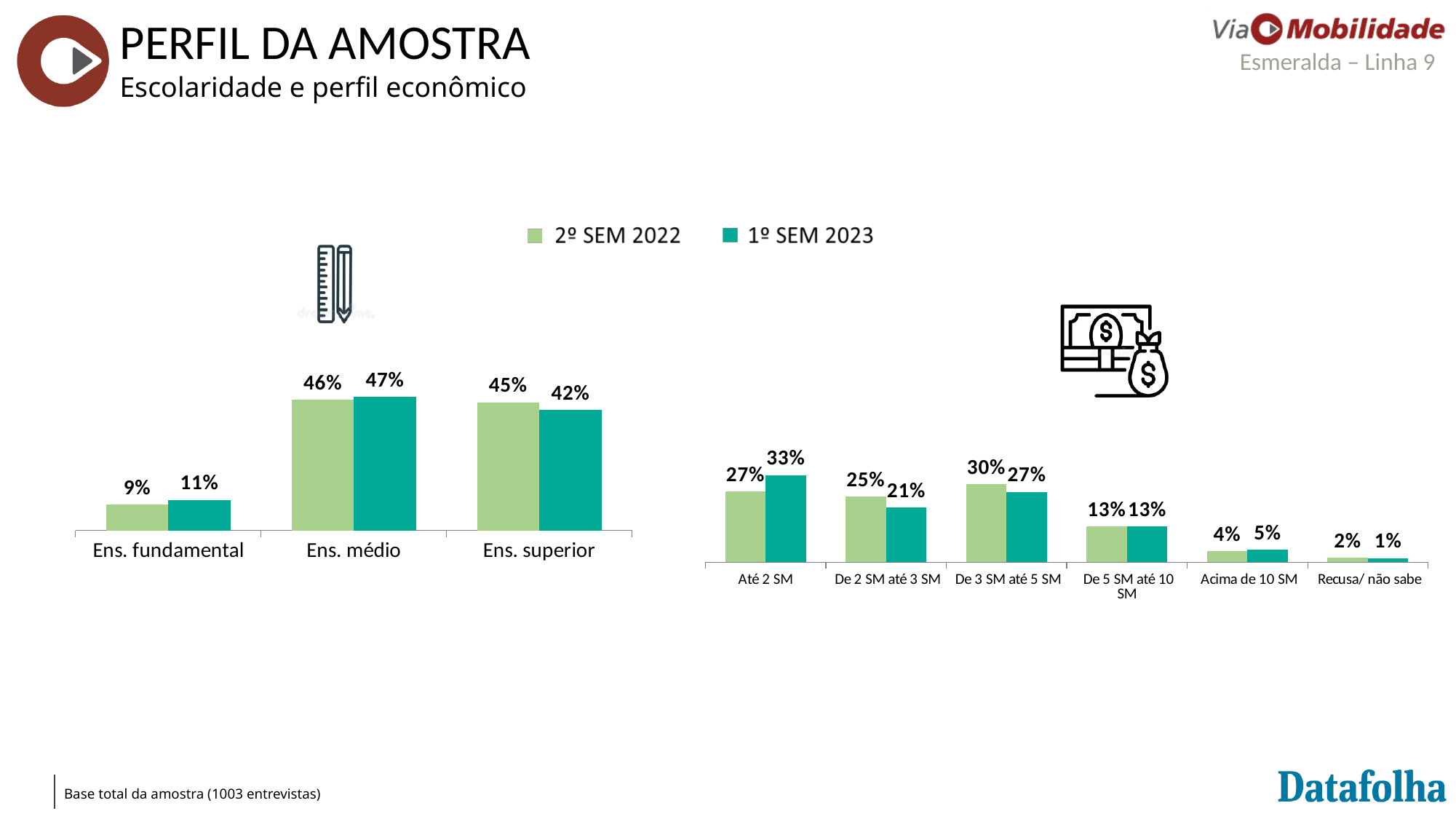
In the right-hand chart (income), what is the value for Até 2 SM in 1º SEM 2023? 33% In the left-hand chart (education level), what is the value for Ens. fundamental in 1º SEM 2023? 11% In the right-hand chart (income), what is the value for De 3 SM até 5 SM in 2º SEM 2022? 30% In the left-hand chart (education level), what is the value for Ens. superior in 2º SEM 2022? 45% In the left-hand chart (education level), which category has the highest value for 1º SEM 2023? Ens. médio In the right-hand chart (income), which is larger for De 2 SM até 3 SM: the 2º SEM 2022 value or the 1º SEM 2023 value? 2º SEM 2022 How many series does the legend list? 2 How many categories are shown in the right-hand chart (income)? 6 In the right-hand chart (income), which category has the lowest value for 1º SEM 2023? Recusa/ não sabe In the right-hand chart (income), what is the difference between the 1º SEM 2023 and 2º SEM 2022 values for Até 2 SM? 6% In the left-hand chart (education level), what is the difference between the 2º SEM 2022 and 1º SEM 2023 values for Ens. superior? 3% What type of chart is the left-hand chart (education level)? Bar chart